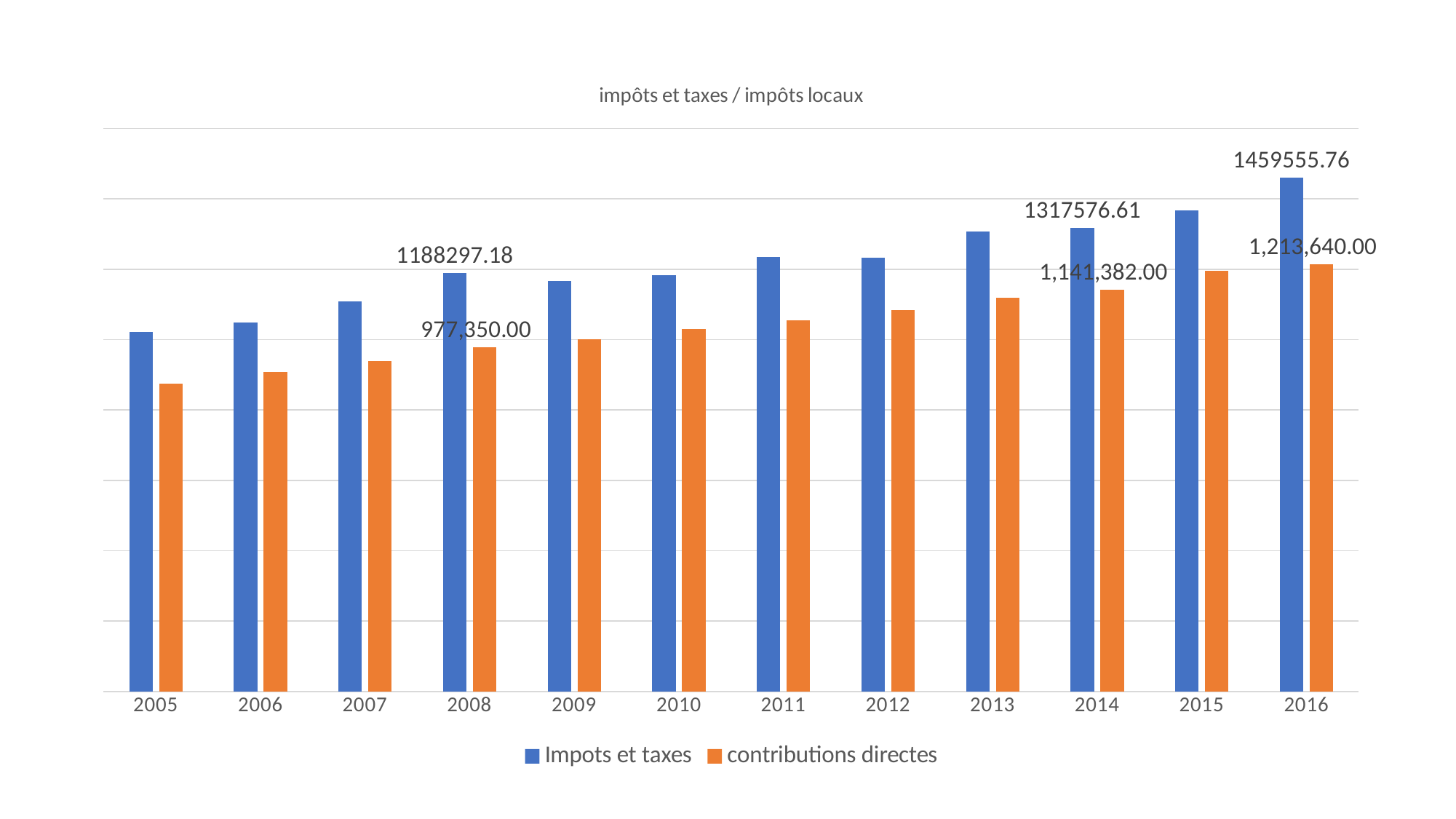
Which year has the highest value for Impots et taxes? 2016 How many years are shown on the x axis? 12 What is the difference between Impots et taxes and contributions directes in 2016? 245915.76 Do the values for contributions directes rise or fall from 2005 to 2016? rise What is the value for contributions directes in 2016? 1,213,640.00 How many series does the legend list? 2 What is the difference between Impots et taxes in 2016 and Impots et taxes in 2008? 271258.58 What is the value for Impots et taxes in 2014? 1317576.61 What is the value for Impots et taxes in 2016? 1459555.76 Which year has the lowest value for contributions directes? 2005 Which is larger: Impots et taxes in 2008 or Impots et taxes in 2007? 2008 What is the value for contributions directes in 2008? 977,350.00